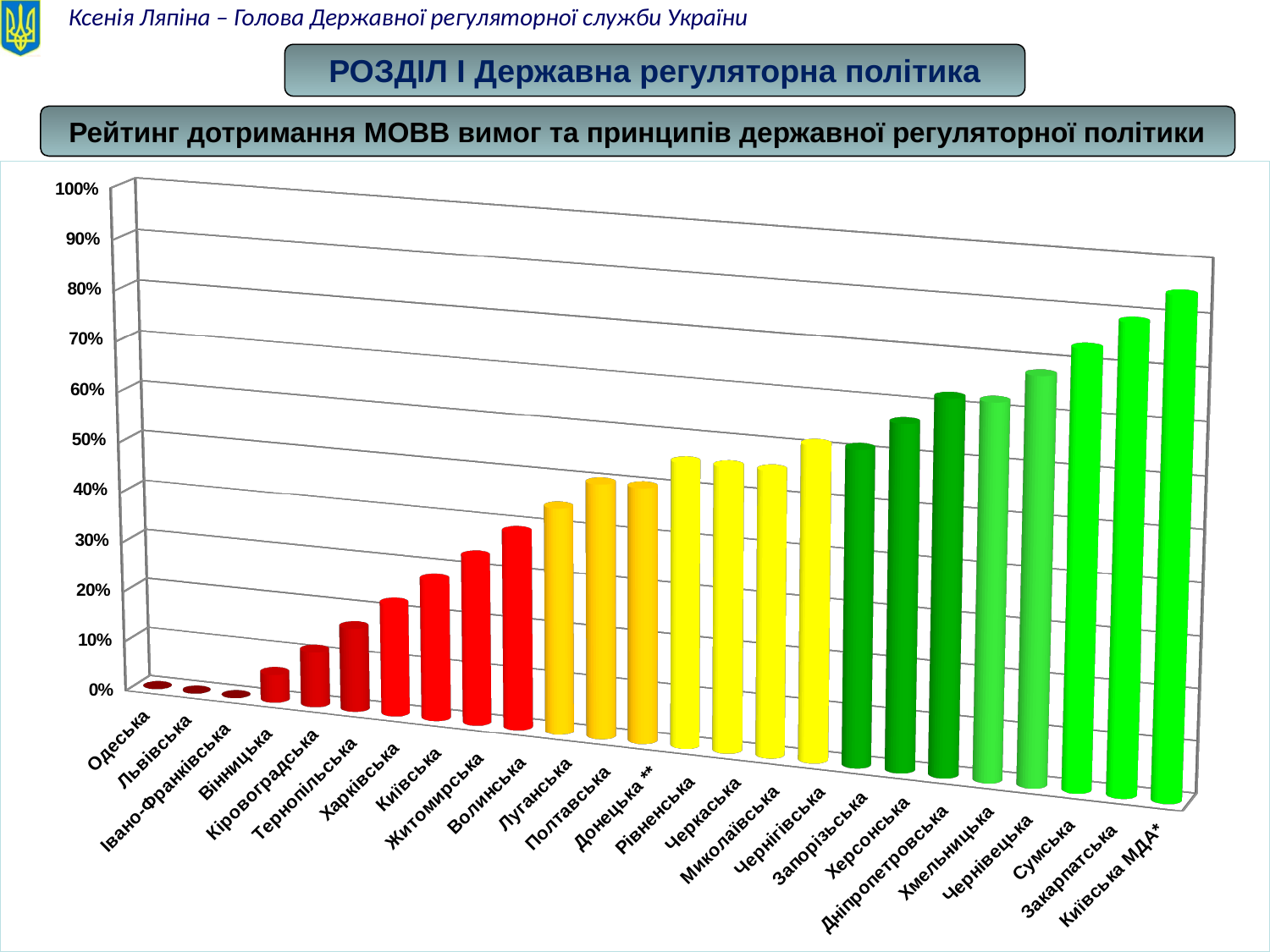
Is the value for Київська МДА* greater or less than 60%? greater How many regions (categories) are plotted on the chart? 25 Is the value for Волинська greater or less than 40%? less Is the value for Запорізька greater or less than 40%? greater What is the title of the chart? Рейтинг дотримання МОВВ вимог та принципів державної регуляторної політики What kind of chart is shown on the slide? bar chart Do the values generally rise or fall moving from left to right along the x axis? rise Which has the larger value, Волинська or Житомирська? Волинська Which has the larger value, Закарпатська or Сумська? Закарпатська Which region has the highest value on the chart? Київська МДА*